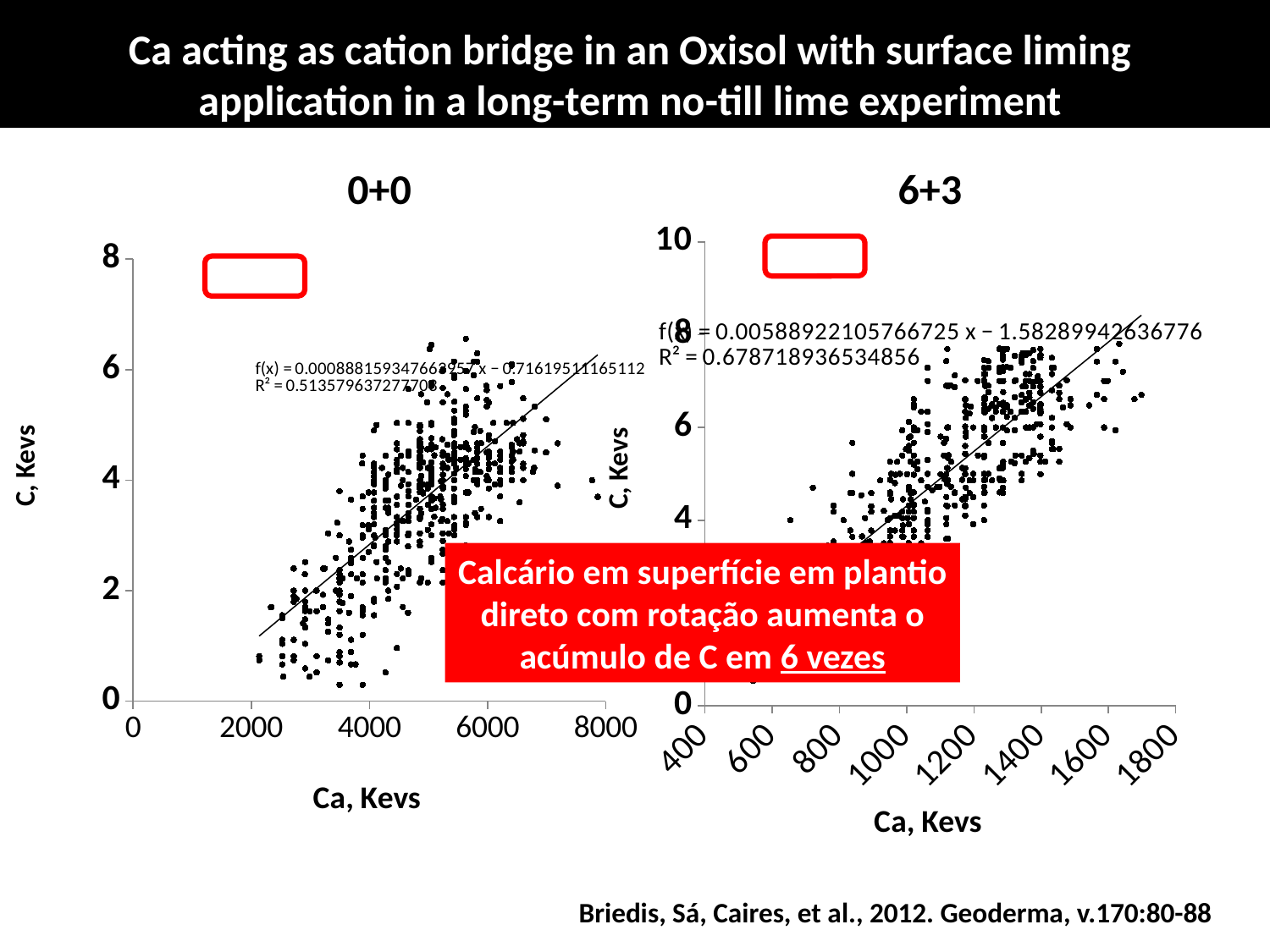
What is the R² value printed on the "0+0" chart? 0.513579637277708 What kind of chart is the "6+3" chart on the right? scatter chart What kind of chart is the "0+0" chart on the left? scatter chart What is the slope (coefficient of x) in the trendline equation on the "6+3" chart? 0.00588922105766725 Which chart has the higher R² value, "0+0" or "6+3"? 6+3 In the "0+0" chart, do the C values generally rise or fall as Ca increases along the x axis? rise What is the R² value printed on the "6+3" chart? 0.678718936534856 What is the intercept in the trendline equation on the "6+3" chart? −1.58289942636776 In the "6+3" chart, do the C values generally rise or fall as Ca increases along the x axis? rise What is the label of the y axis on the "6+3" chart? C, Kevs What is the highest tick value shown on the x axis of the "6+3" chart? 1800 What is the label of the x axis on the "0+0" chart? Ca, Kevs